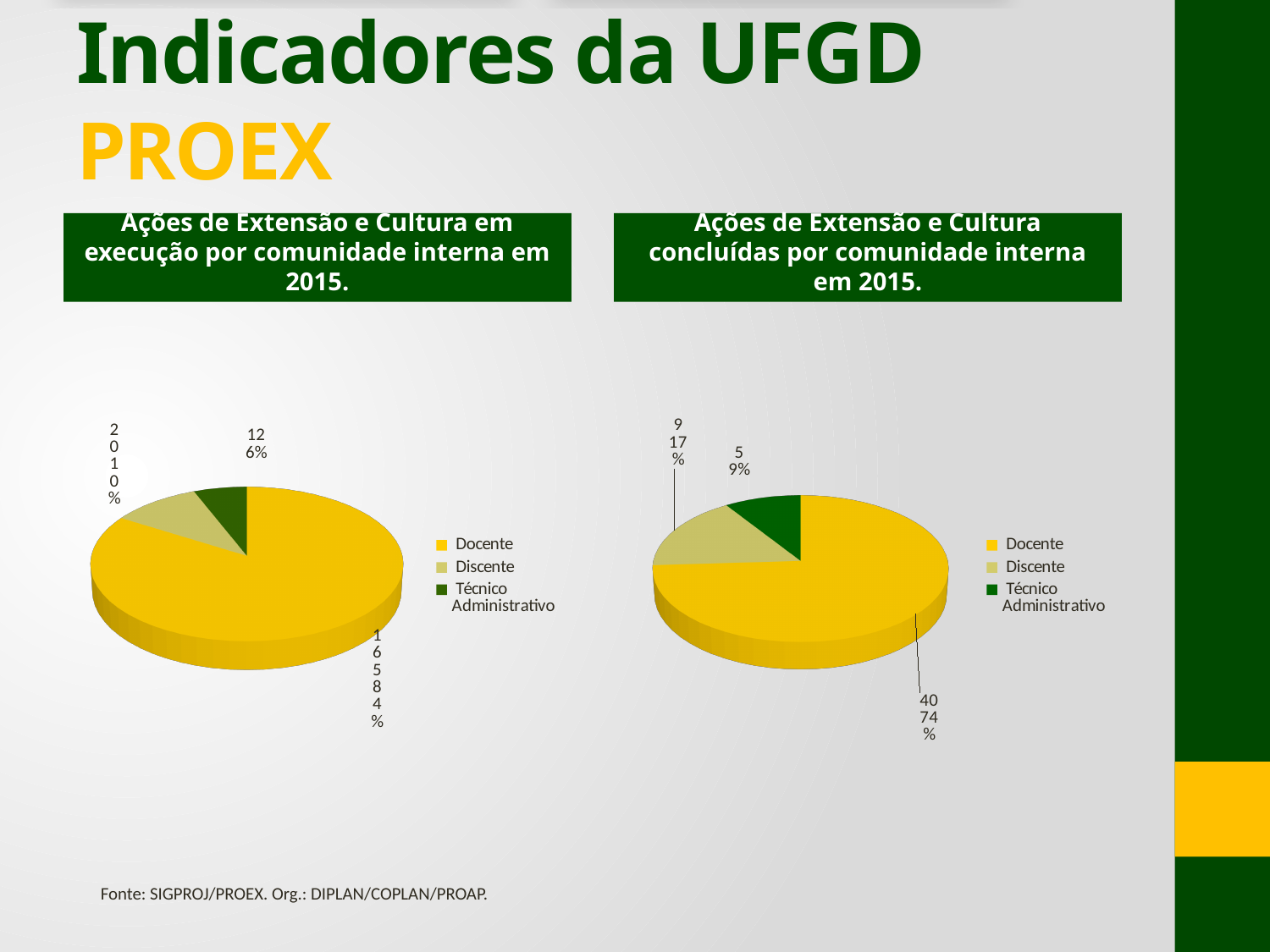
In the left chart (ações em execução), which category has the smallest slice? Técnico Administrativo In the right chart (ações concluídas), what value is shown for Docente? 40 In the right chart (ações concluídas), which is larger, Discente or Técnico Administrativo? Discente In the left chart (ações em execução), what value is shown for Técnico Administrativo? 12 How many entries does the legend of the right chart (ações concluídas) list? 3 In the left chart (ações em execução), what is the difference between the Docente value and the Discente value? 145 In the left chart (ações em execução), which category has the largest slice? Docente In the left chart (ações em execução), what percentage share does Discente have? 10% What type of chart is used for 'Ações de Extensão e Cultura em execução por comunidade interna em 2015'? Pie chart In the left chart (ações em execução), what value is shown for Docente? 165 In the right chart (ações concluídas), what is the difference between the Discente value and the Técnico Administrativo value? 4 In the right chart (ações concluídas), what percentage share does Técnico Administrativo have? 9%